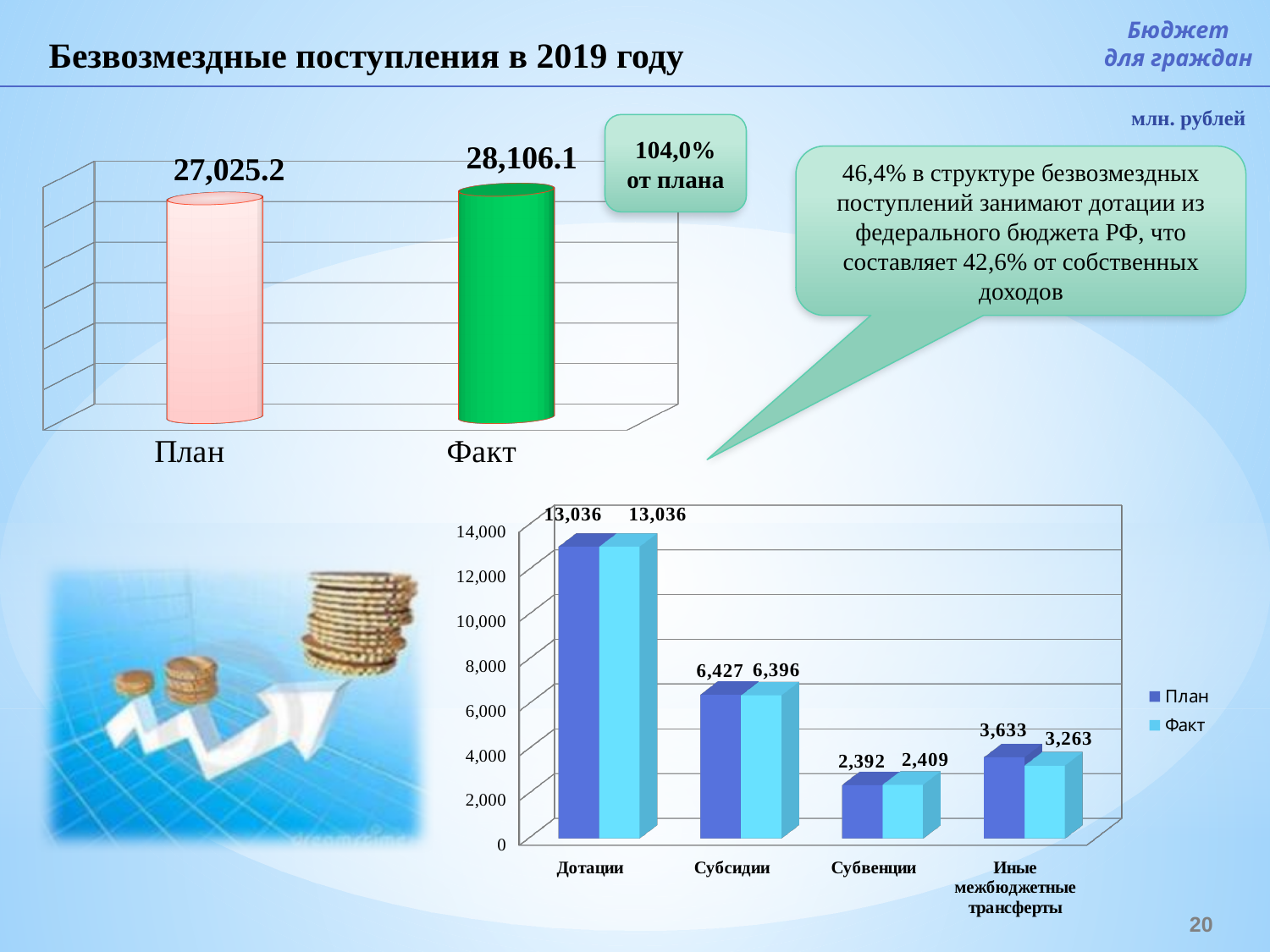
On the bottom-right chart, what is the difference between План and Факт for Иные межбюджетные трансферты? 370 On the top-left chart, what is the value for Факт? 28,106.1 On the bottom-right chart, how many categories are shown on the x axis? 4 On the top-left chart, what is the difference between Факт and План? 1,080.9 On the bottom-right chart, which category has the lowest План value? Субвенции On the bottom-right chart, which category has the highest values? Дотации On the bottom-right chart, what is the План value for Дотации? 13,036 On the bottom-right chart, how many series does the legend list? 2 On the bottom-right chart, what is the Факт value for Субсидии? 6,396 On the top-left chart, what is the value for План? 27,025.2 On the top-left chart, which is larger, План or Факт? Факт On the bottom-right chart, what is the Факт value for Иные межбюджетные трансферты? 3,263